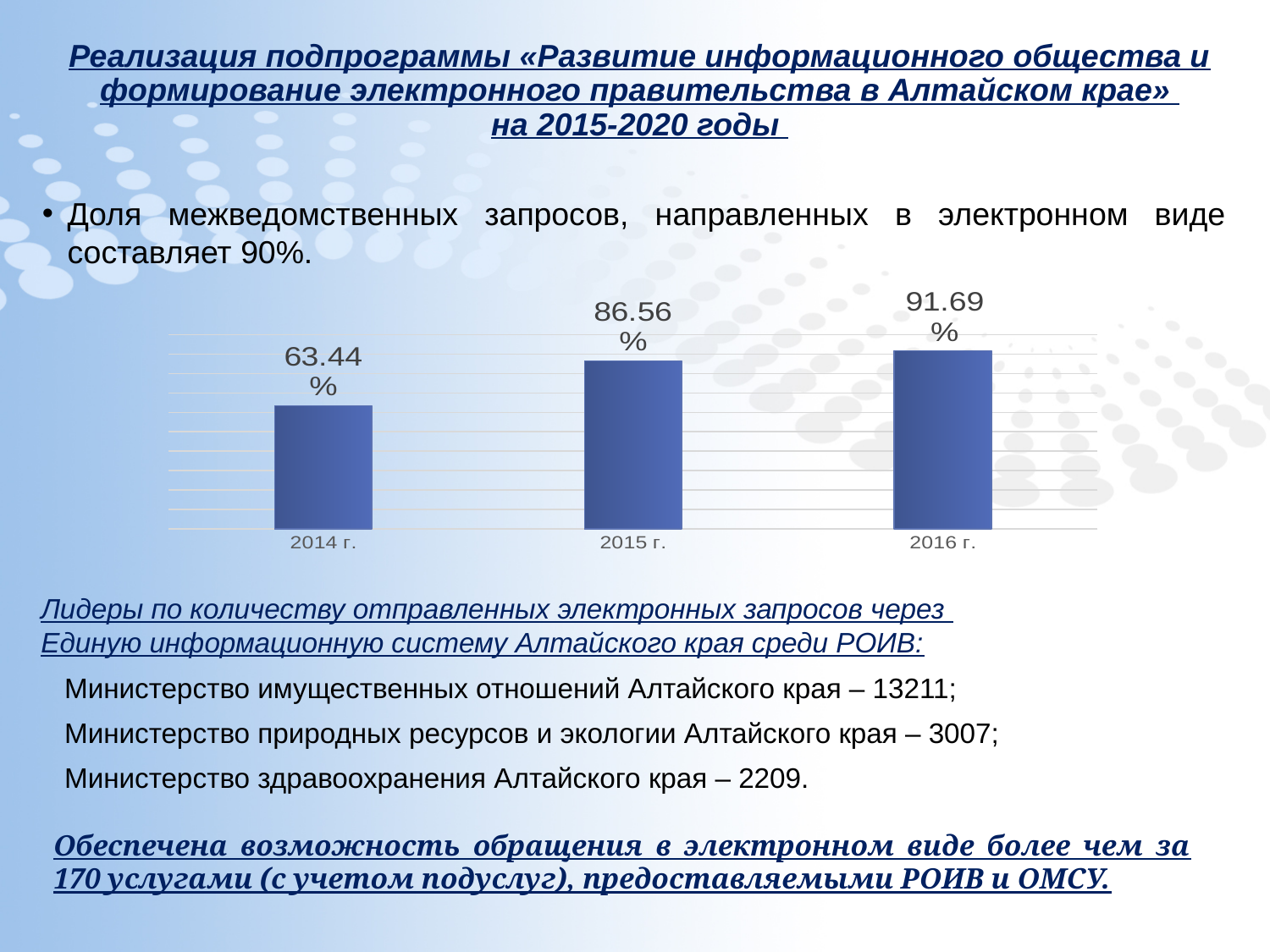
What is the value for 2014 г.? 63.44% What is the difference between the values for 2015 г. and 2014 г.? 23.12% Which year has the lowest value? 2014 г. Which year has the highest value? 2016 г. What is the value for 2015 г.? 86.56% Do the values rise or fall from 2014 г. to 2016 г.? rise How many years are shown in the chart? 3 What kind of chart is shown on the slide? bar chart What colour are the bars in the chart? blue What is the difference between the values for 2016 г. and 2015 г.? 5.13% Which is larger, the value for 2014 г. or the value for 2015 г.? 2015 г. What is the value for 2016 г.? 91.69%